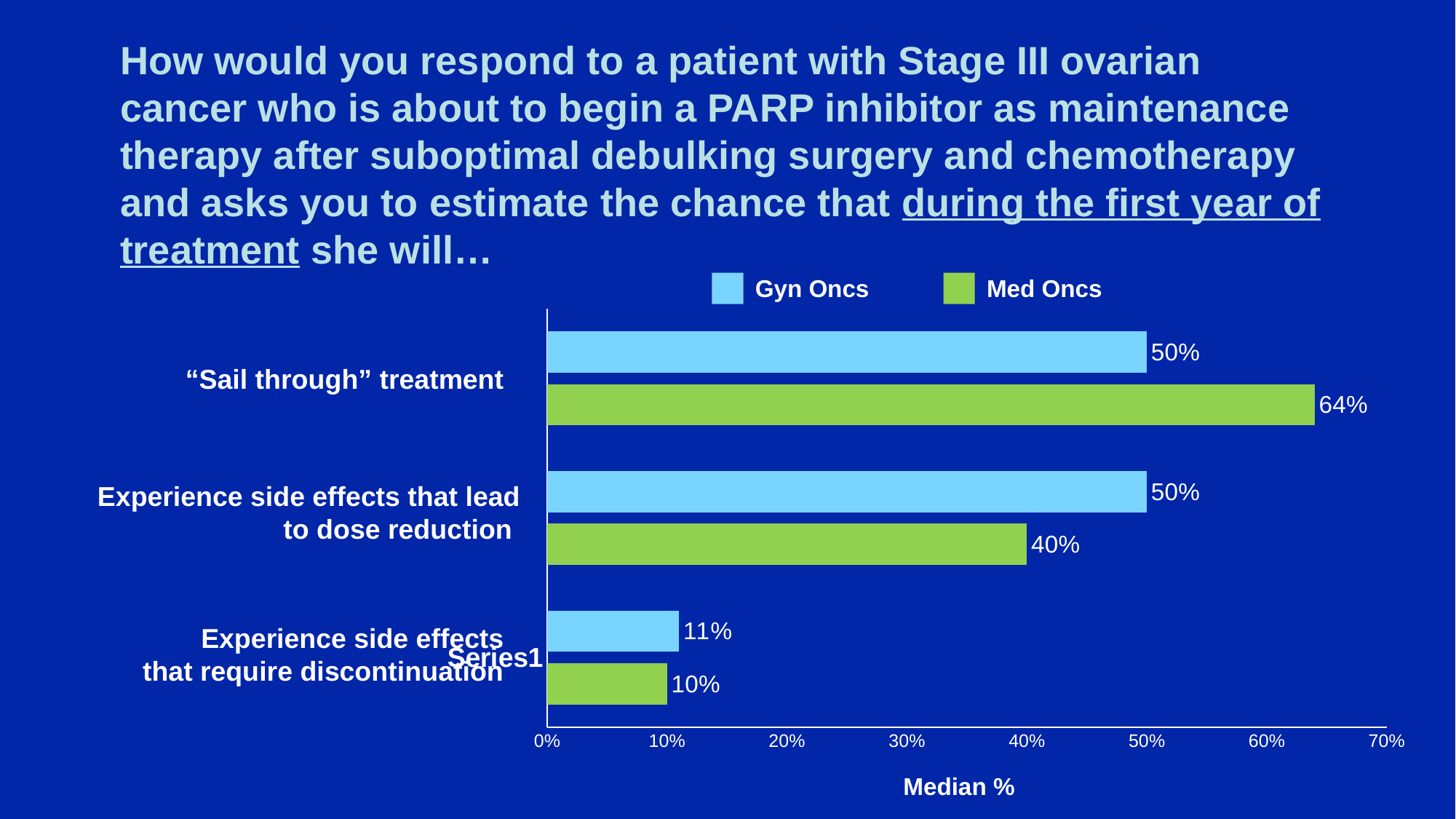
For Experience side effects that lead to dose reduction, which is larger: the Gyn Oncs value or the Med Oncs value? Gyn Oncs What is the Gyn Oncs value for Experience side effects that require discontinuation? 11% How many series does the legend list? 2 Which category has the highest Med Oncs value? "Sail through" treatment What is the difference between the Med Oncs and Gyn Oncs values for "Sail through" treatment? 14% What is the Med Oncs value for Experience side effects that require discontinuation? 10% What is the label of the horizontal axis? Median % What kind of chart is shown on the slide? Bar chart What is the Med Oncs value for Experience side effects that lead to dose reduction? 40% Which category has the lowest Gyn Oncs value? Experience side effects that require discontinuation What is the Med Oncs value for "Sail through" treatment? 64% What is the Gyn Oncs value for "Sail through" treatment? 50%